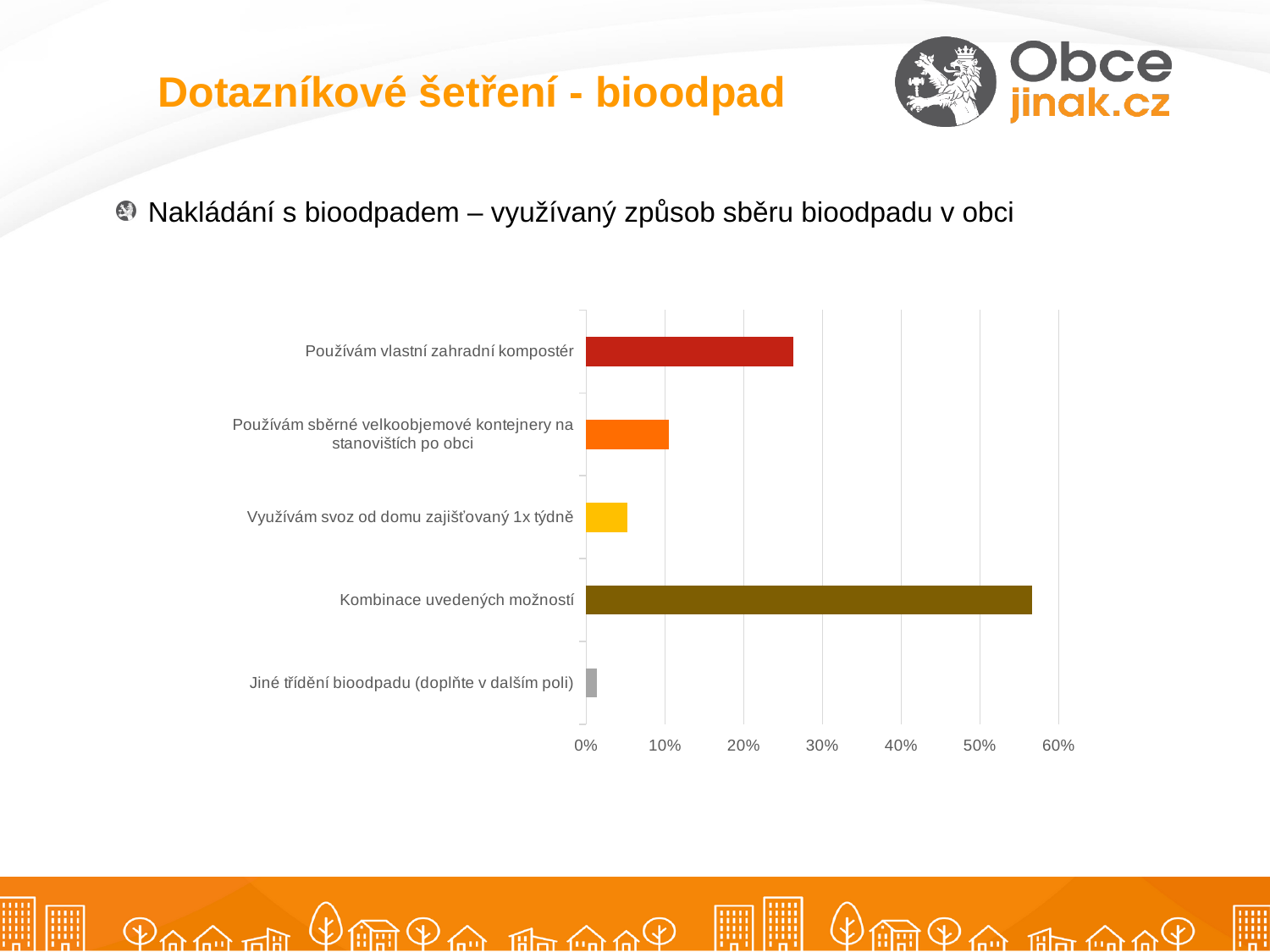
Which category has the highest value in the chart? Kombinace uvedených možností Is the value for "Používám vlastní zahradní kompostér" greater or less than 20%? greater Is the value for "Využívám svoz od domu zajišťovaný 1x týdně" greater or less than 10%? less Which is larger: the value for "Využívám svoz od domu zajišťovaný 1x týdně" or for "Jiné třídění bioodpadu (doplňte v dalším poli)"? Využívám svoz od domu zajišťovaný 1x týdně Is the value for "Kombinace uvedených možností" greater or less than 50%? greater What is the highest value shown on the horizontal axis of the chart? 60% How many categories (collection methods) are plotted in the chart? 5 Which is larger: the value for "Používám vlastní zahradní kompostér" or for "Používám sběrné velkoobjemové kontejnery na stanovištích po obci"? Používám vlastní zahradní kompostér Which category has the lowest value in the chart? Jiné třídění bioodpadu (doplňte v dalším poli) What kind of chart is shown on the slide? bar chart